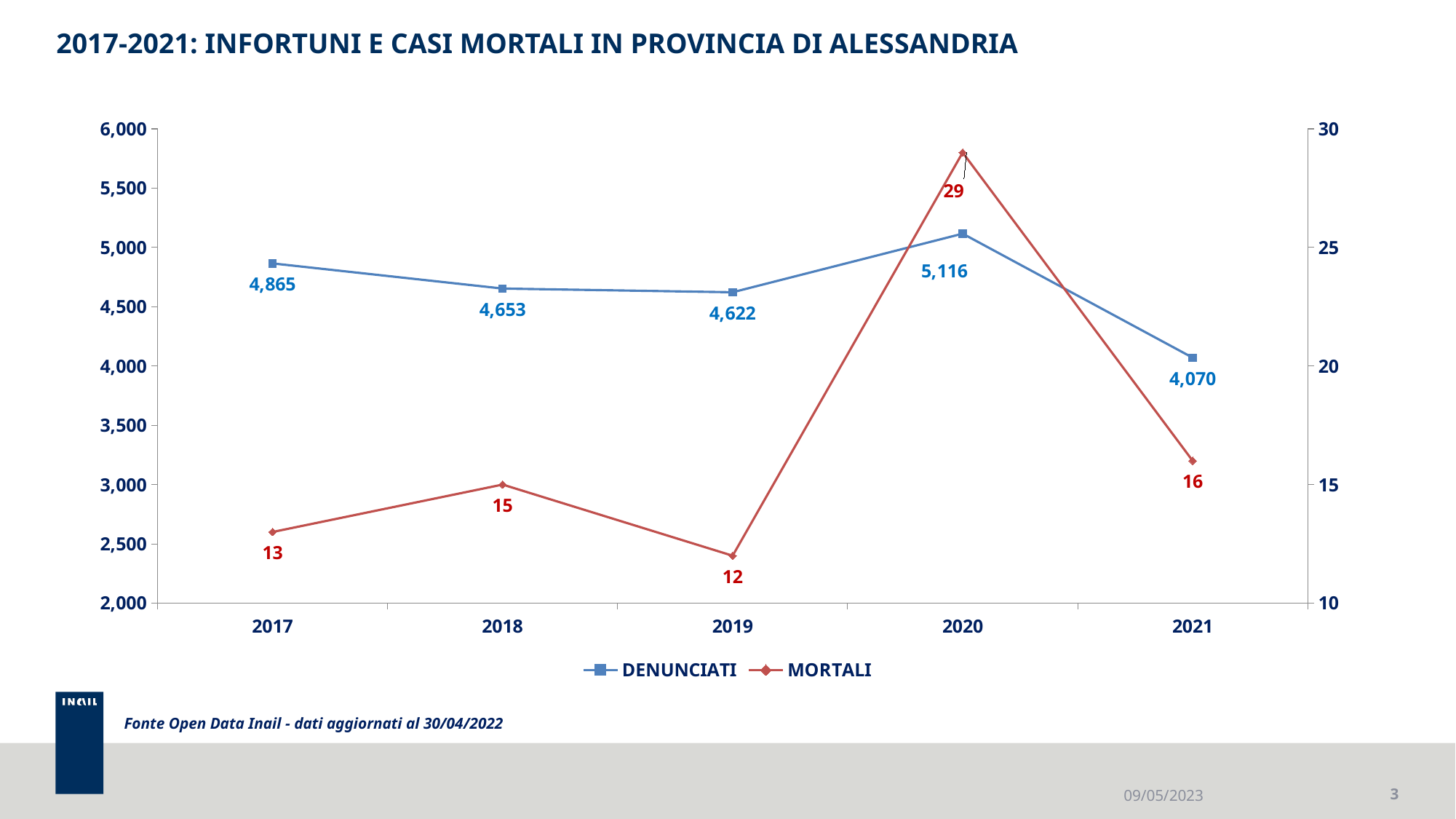
What is the difference between the DENUNCIATI values for 2017 and 2018? 212 In which year is the MORTALI series highest? 2020 What is the difference between the MORTALI values for 2020 and 2021? 13 What is the MORTALI value for 2019? 12 What kind of chart is shown on the slide? line chart In which year is the DENUNCIATI series lowest? 2021 What is the DENUNCIATI value for 2020? 5,116 What is the DENUNCIATI value for 2021? 4,070 How many years are shown on the x axis? 5 Does the DENUNCIATI series rise or fall from 2020 to 2021? fall Which is larger, the DENUNCIATI value for 2019 or for 2020? 2020 How many series does the legend list? 2